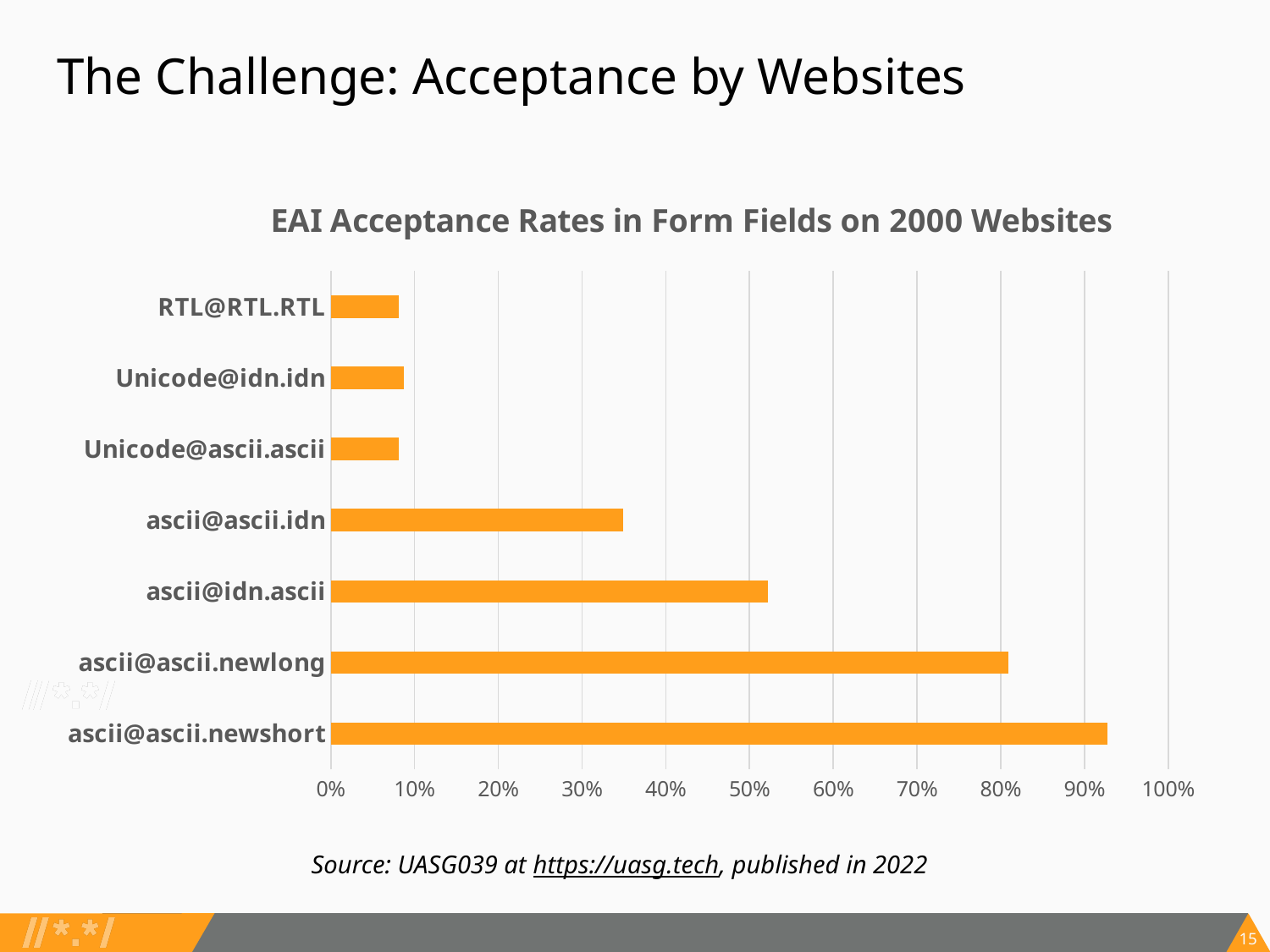
Is the value for RTL@RTL.RTL greater or less than 10%? less Which category has the highest acceptance rate? ascii@ascii.newshort Is the value for ascii@ascii.idn greater or less than 40%? less Is the value for ascii@idn.ascii greater or less than 50%? greater Which is larger, the value for ascii@ascii.idn or the value for ascii@idn.ascii? ascii@idn.ascii What type of chart is shown on the slide? bar chart How many categories are plotted in the chart? 7 What is the title of the chart? EAI Acceptance Rates in Form Fields on 2000 Websites What colour are the bars in the chart? orange Which is larger, the value for Unicode@idn.idn or the value for ascii@ascii.newlong? ascii@ascii.newlong